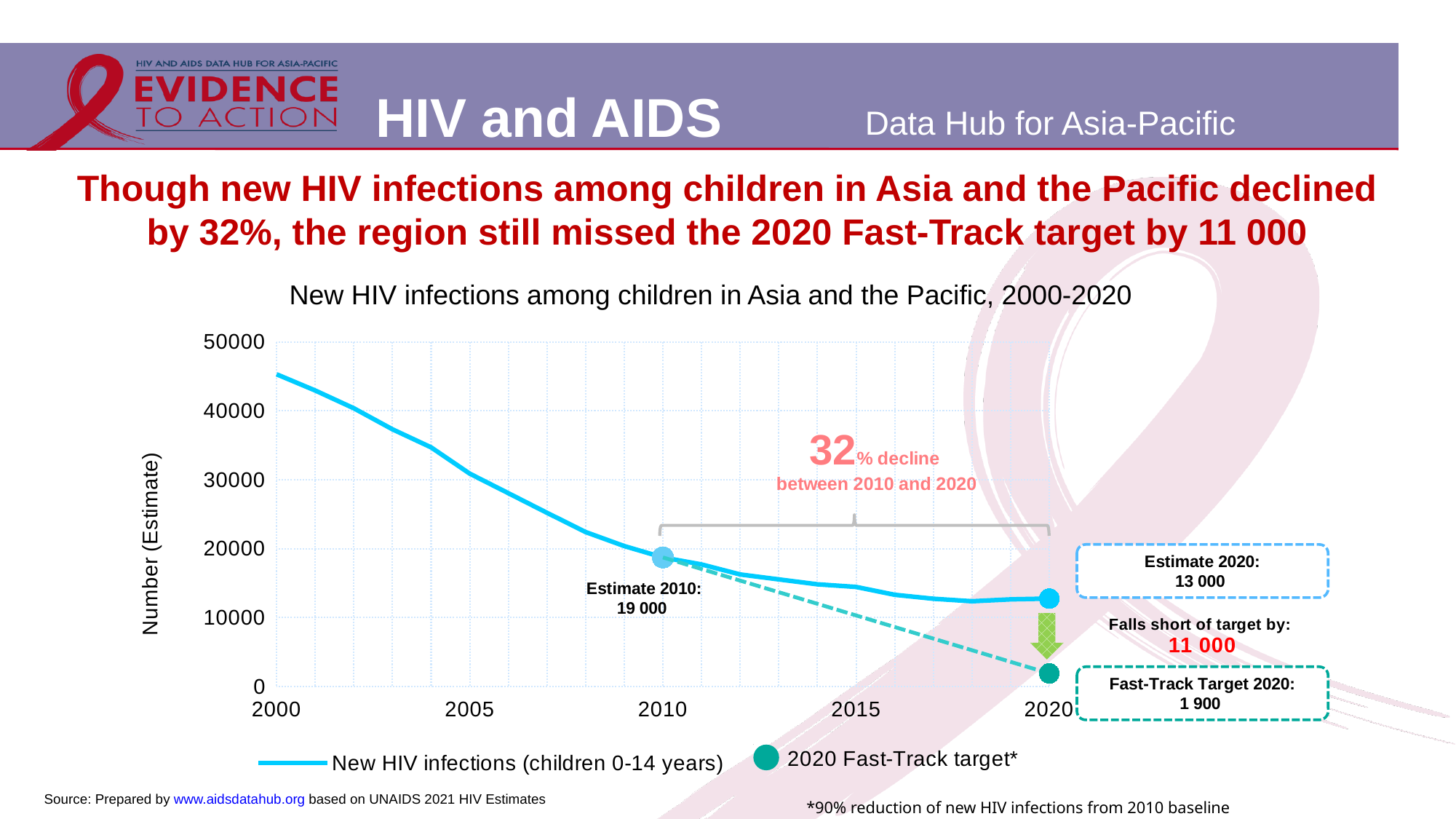
Is the value for new HIV infections among children in 2000 greater or less than 40000? greater What is the title of the chart? New HIV infections among children in Asia and the Pacific, 2000-2020 What is the percentage decline in new HIV infections among children between 2010 and 2020? 32% How many entries does the chart legend list? 2 What is the estimated number of new HIV infections among children in 2020? 13 000 What is the 2020 Fast-Track target for new HIV infections among children? 1 900 Which is larger, the 2020 estimate or the 2020 Fast-Track target? 2020 estimate What kind of chart is shown on the slide? line chart What is the estimated number of new HIV infections among children in 2010? 19 000 Do new HIV infections among children rise or fall from 2000 to 2020? fall By how much does the 2020 estimate fall short of the 2020 Fast-Track target? 11 000